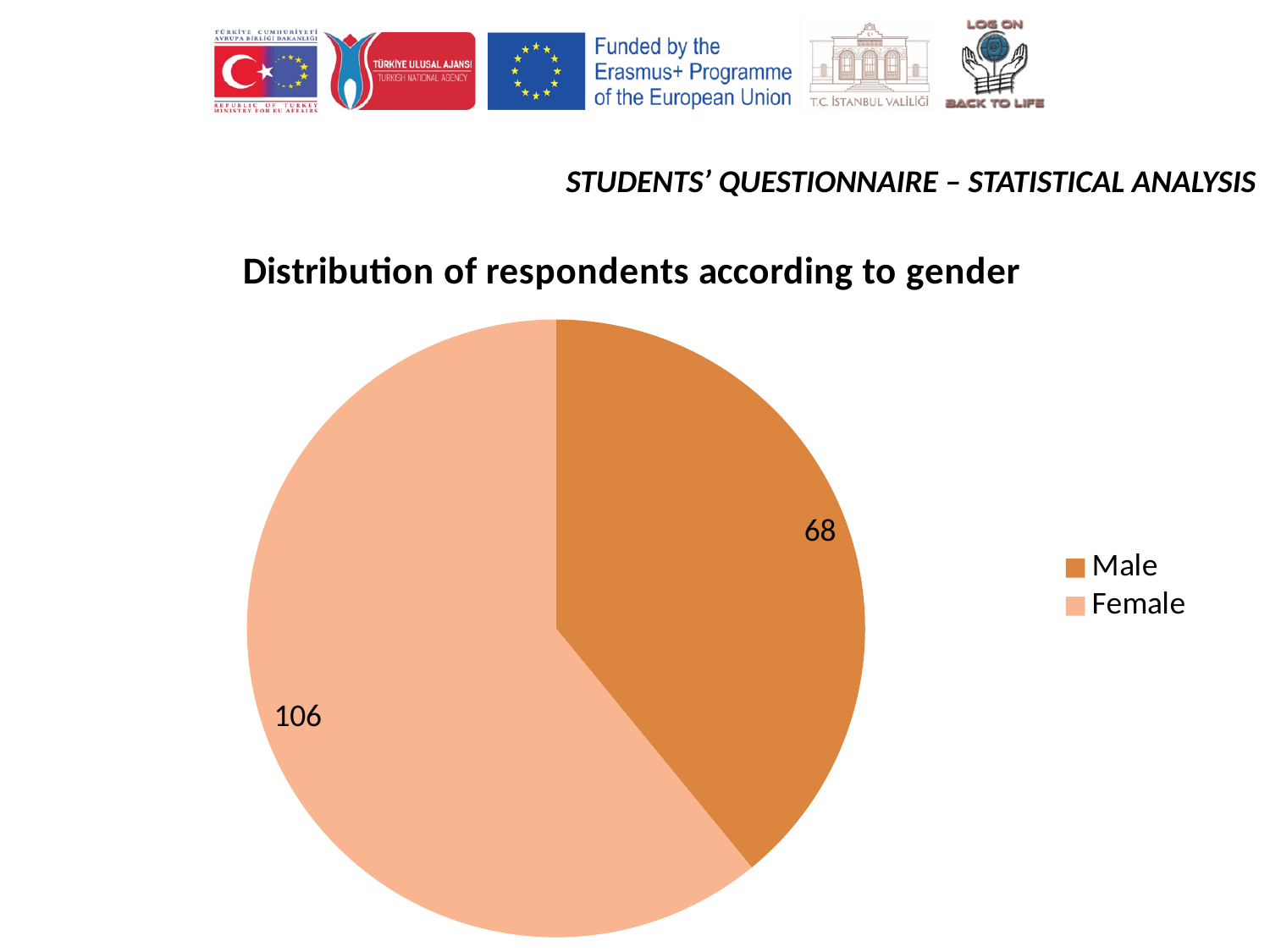
How many entries does the legend list? 2 What is the total number of respondents shown in the pie chart? 174 What is the value for Male? 68 Which is larger, the value for Male or the value for Female? Female What is the difference between the number of Female and Male respondents? 38 What is the title of the chart? Distribution of respondents according to gender What kind of chart is shown on the slide? pie chart How many slices does the pie chart have? 2 Which legend entry is shown in the darker orange colour? Male Which gender has the lowest number of respondents? Male Which gender has the highest number of respondents? Female What is the value for Female? 106